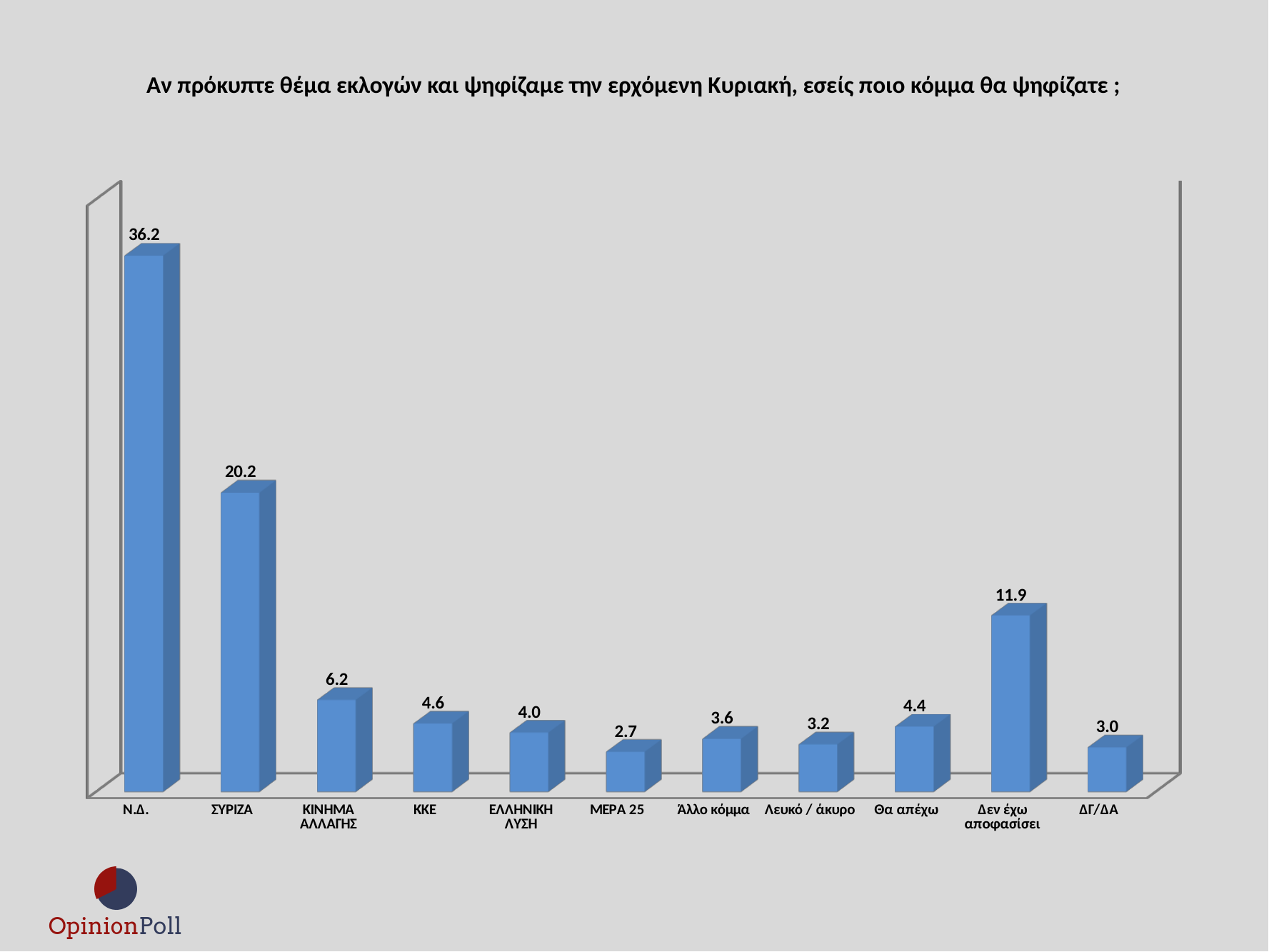
What is the difference between the values for ΚΙΝΗΜΑ ΑΛΛΑΓΗΣ and ΚΚΕ? 1.6 What is the value for Δεν έχω αποφασίσει? 11.9 What is the value for Ν.Δ.? 36.2 What colour are the bars in the chart? Blue What is the difference between the values for Ν.Δ. and ΣΥΡΙΖΑ? 16.0 How many categories are shown on the x axis? 11 What is the value for ΚΚΕ? 4.6 Which category has the highest value? Ν.Δ. What kind of chart is shown on the slide? Bar chart Which category has the lowest value? ΜΕΡΑ 25 What is the value for ΣΥΡΙΖΑ? 20.2 Which is larger, the value for Θα απέχω or the value for Άλλο κόμμα? Θα απέχω